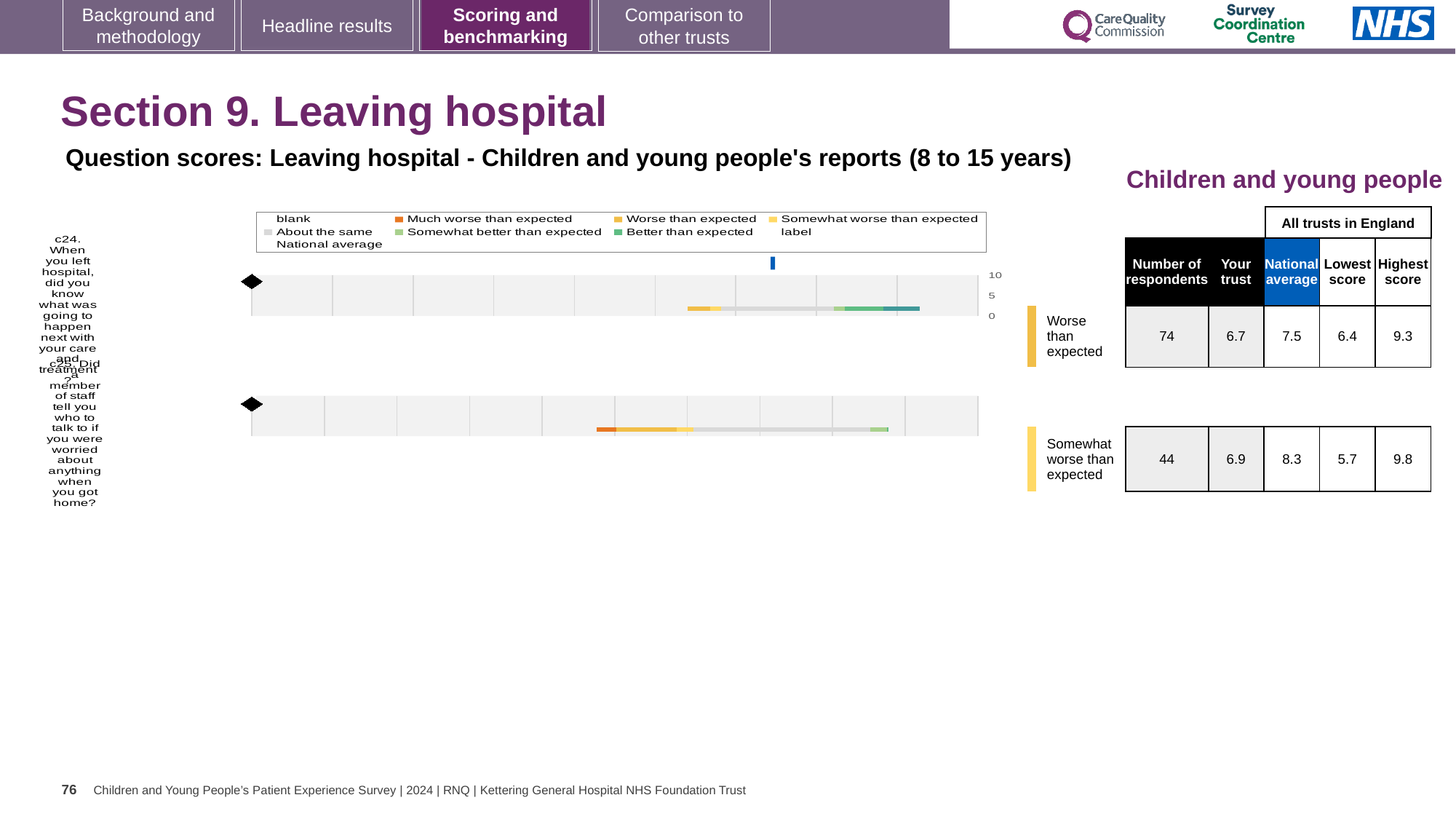
How many respondents answered question c24? 74 What is the lowest score among all trusts in England for question c25? 5.7 Which benchmarking category is the trust's score for question c24 placed in? Worse than expected For question c24, what is the national average score? 7.5 For question c25 (Did a member of staff tell you who to talk to if you were worried about anything when you got home?), what is the 'Your trust' score? 6.9 How many respondents answered question c25? 44 What is the highest score among all trusts in England for question c24? 9.3 For question c25, how much higher is the national average than the 'Your trust' score? 1.4 What kind of chart is used to show the question scores on this slide? Bar chart For question c25, what is the national average score? 8.3 Which question had more respondents, c24 or c25? c24 For question c24 (When you left hospital, did you know what was going to happen next with your care and treatment?), what is the 'Your trust' score? 6.7